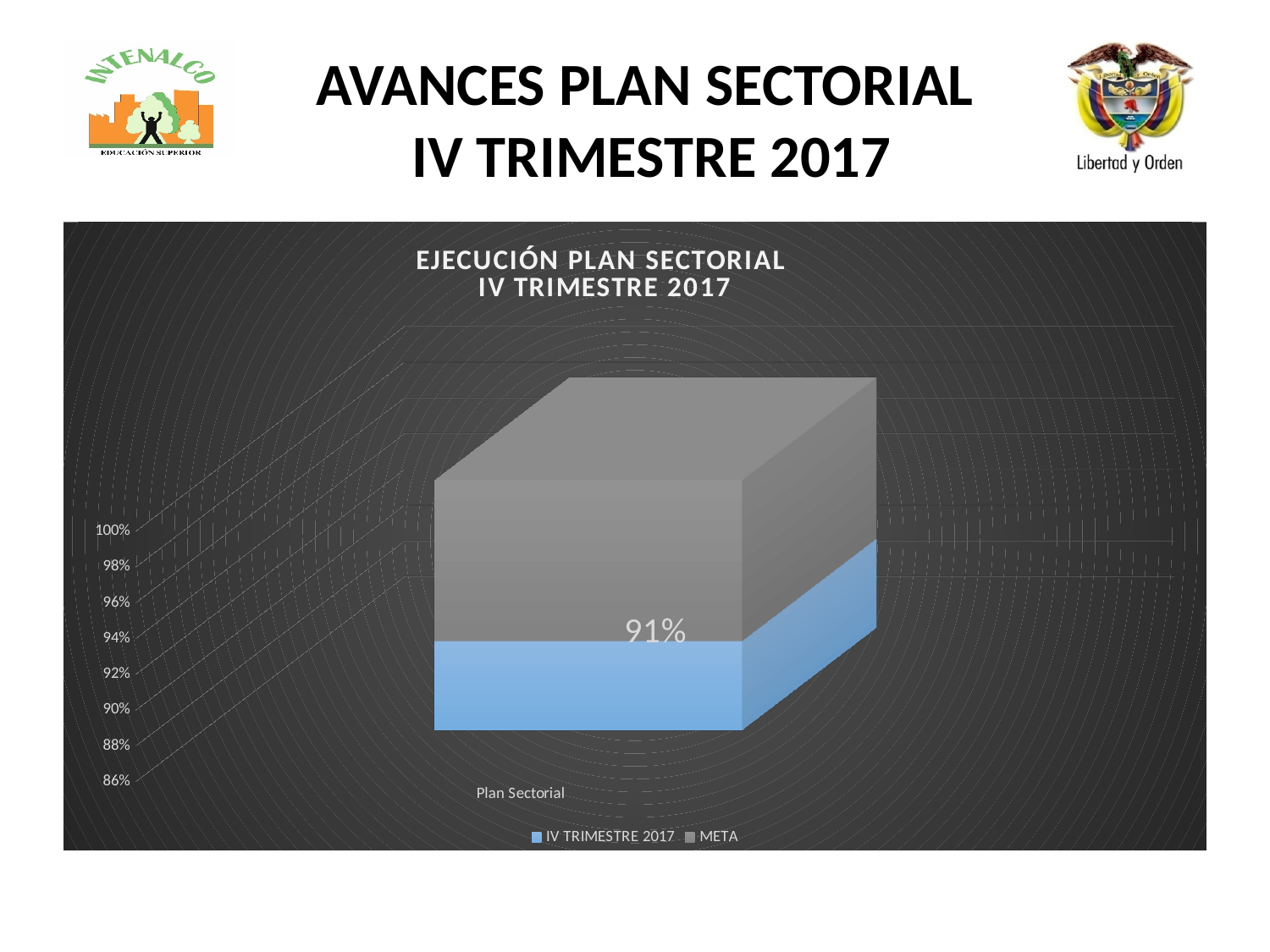
What type of chart is shown on the slide? bar chart How many categories are shown on the x axis of the chart? 1 What is the lowest value shown on the chart's vertical axis? 86% What is the highest value shown on the chart's vertical axis? 100% What is the title of the chart? EJECUCIÓN PLAN SECTORIAL IV TRIMESTRE 2017 What is the name of the category shown on the x axis? Plan Sectorial What are the two series named in the chart legend? IV TRIMESTRE 2017 and META How many series does the chart legend list? 2 What value is printed as a data label on the chart? 91%